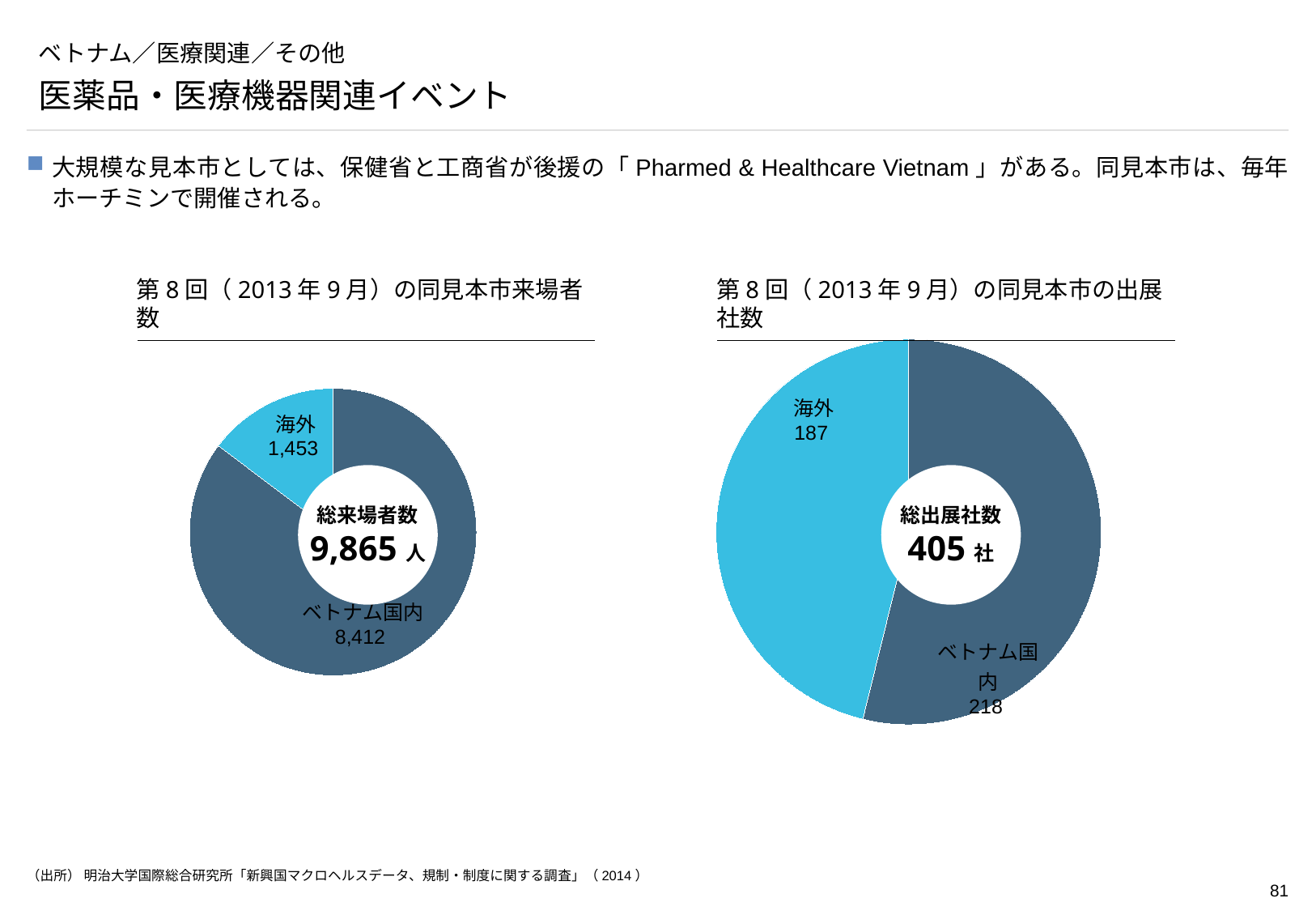
In the left chart (第8回の同見本市来場者数), which category is the largest? ベトナム国内 In the right chart (第8回の同見本市の出展社数), which category is the smallest? 海外 In the right chart (第8回の同見本市の出展社数), what is the value for 海外? 187 What kind of chart is used for the left chart (第8回の同見本市来場者数)? Donut (pie) chart In the right chart (第8回の同見本市の出展社数), what is the value for ベトナム国内? 218 In the left chart (第8回の同見本市来場者数), what is the value for ベトナム国内? 8,412 How many categories does the right chart (第8回の同見本市の出展社数) show? 2 In the right chart (第8回の同見本市の出展社数), what is the total number of exhibitors shown in the centre? 405 社 In the right chart (第8回の同見本市の出展社数), what is the difference between ベトナム国内 and 海外? 31 In the left chart (第8回の同見本市来場者数), what is the total number of visitors shown in the centre? 9,865 人 In the left chart (第8回の同見本市来場者数), what is the value for 海外? 1,453 In the left chart (第8回の同見本市来場者数), what is the difference between ベトナム国内 and 海外? 6,959